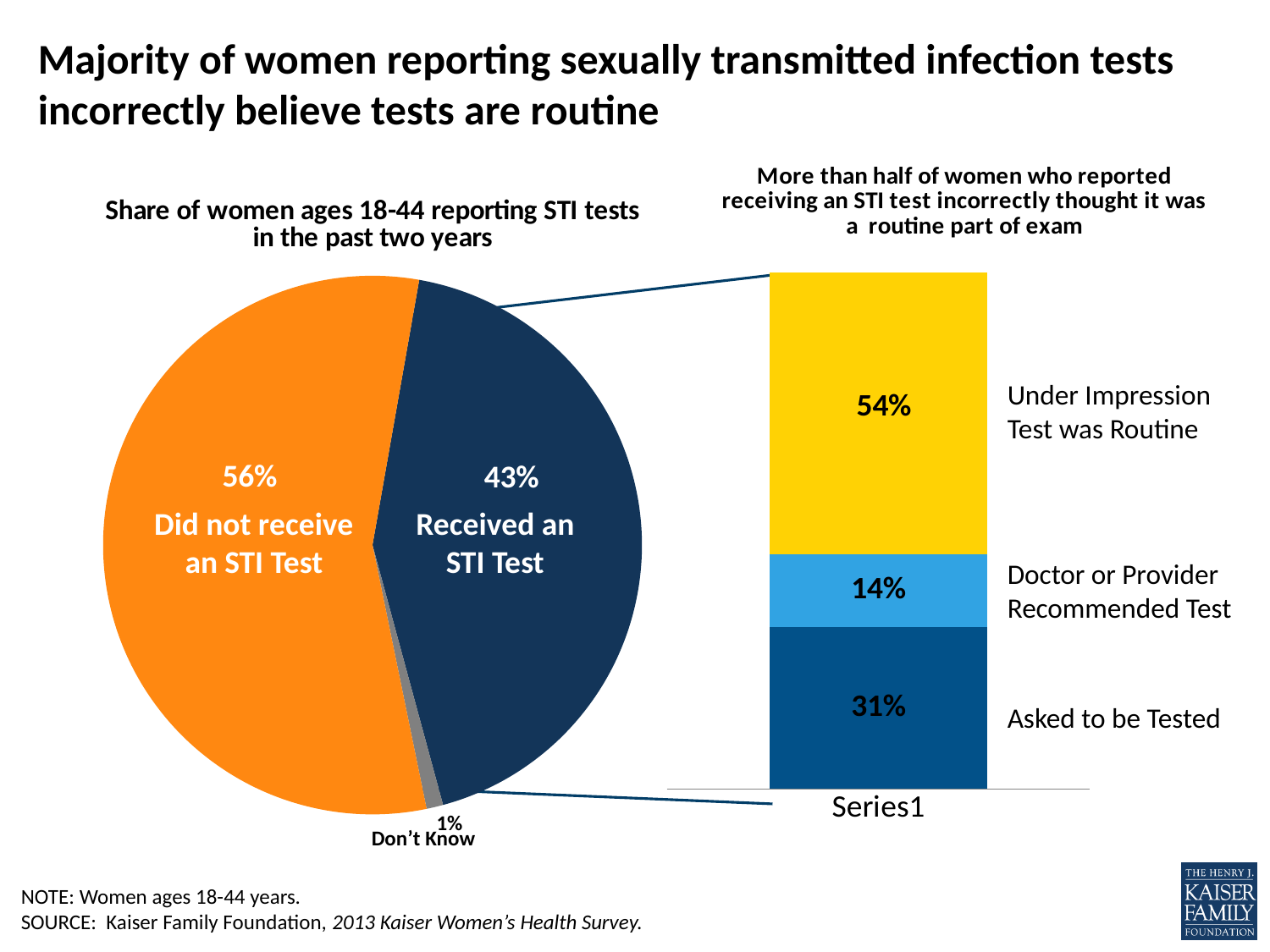
In the pie chart, what is the difference between the share who did not receive an STI test and the share who received one? 13 percentage points In the pie chart, which slice is the smallest? Don't Know In the pie chart, how many slices are there? 3 In the pie chart, what share of women ages 18-44 did not receive an STI test in the past two years? 56% In the pie chart, which slice is the largest? Did not receive an STI Test What type of chart is shown on the left side of the slide? Pie chart In the pie chart, what share of women received an STI test? 43% In the stacked bar chart on the right, what share of women said a doctor or provider recommended the test? 14% In the stacked bar chart on the right, what share of women were under the impression the test was routine? 54% In the stacked bar chart on the right, which segment is the smallest? Doctor or Provider Recommended Test In the stacked bar chart on the right, what share of women asked to be tested? 31% In the pie chart, what share of women answered Don't Know? 1%